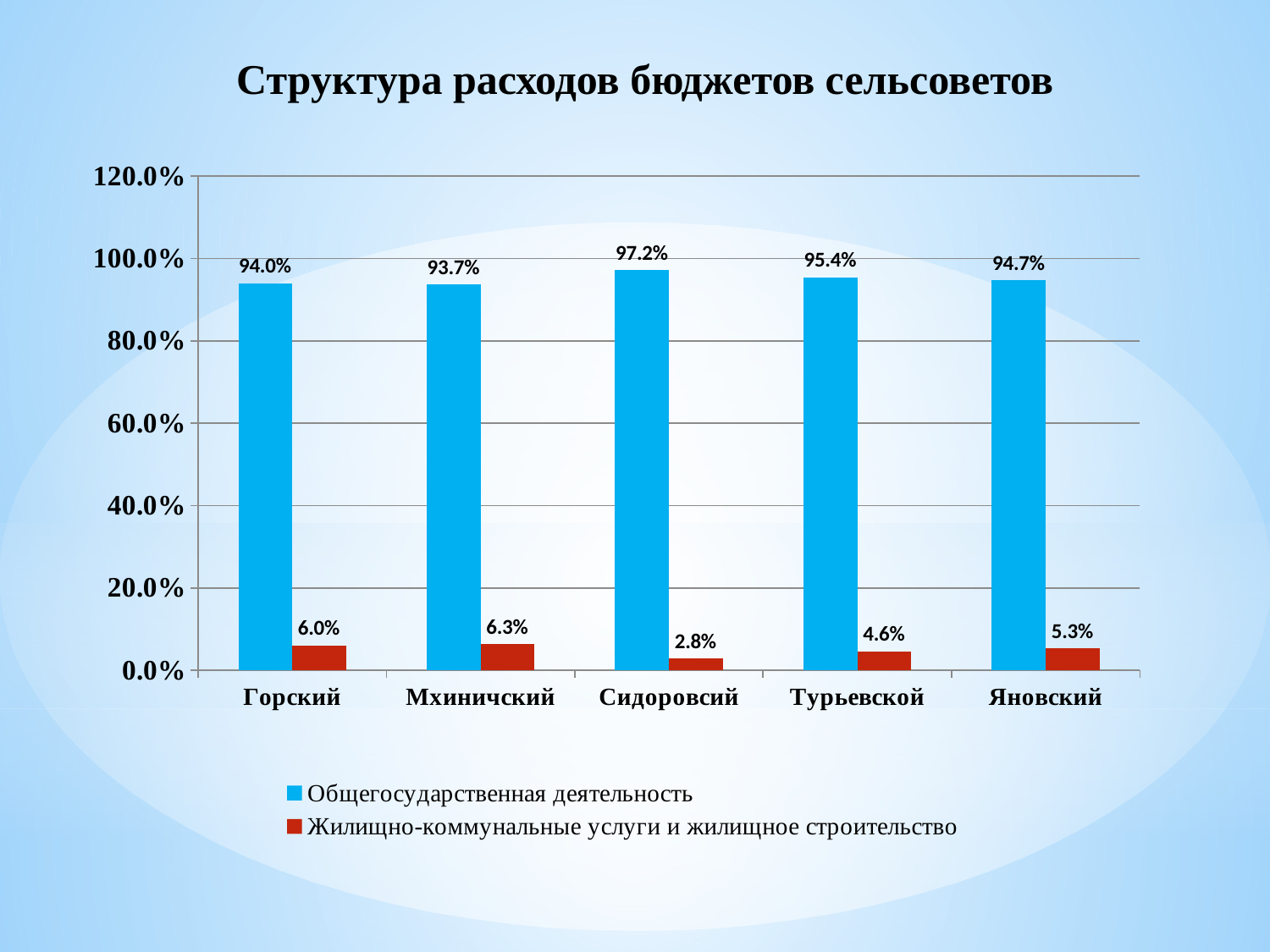
How many series does the legend list? 2 What is the difference between the Общегосударственная деятельность values for Сидоровсий and Горский? 3.2% How many categories are shown on the x axis? 5 What is the value of Жилищно-коммунальные услуги и жилищное строительство for Мхиничский? 6.3% Which category has the highest value for Общегосударственная деятельность? Сидоровсий What is the title of the chart? Структура расходов бюджетов сельсоветов Which category has the lowest value for Общегосударственная деятельность? Мхиничский What is the value of Общегосударственная деятельность for Яновский? 94.7% What is the value of Общегосударственная деятельность for Сидоровсий? 97.2% What kind of chart is shown on the slide? Bar chart Which is larger: the Жилищно-коммунальные услуги и жилищное строительство value for Горский or for Турьевской? Горский Which category has the lowest value for Жилищно-коммунальные услуги и жилищное строительство? Сидоровсий